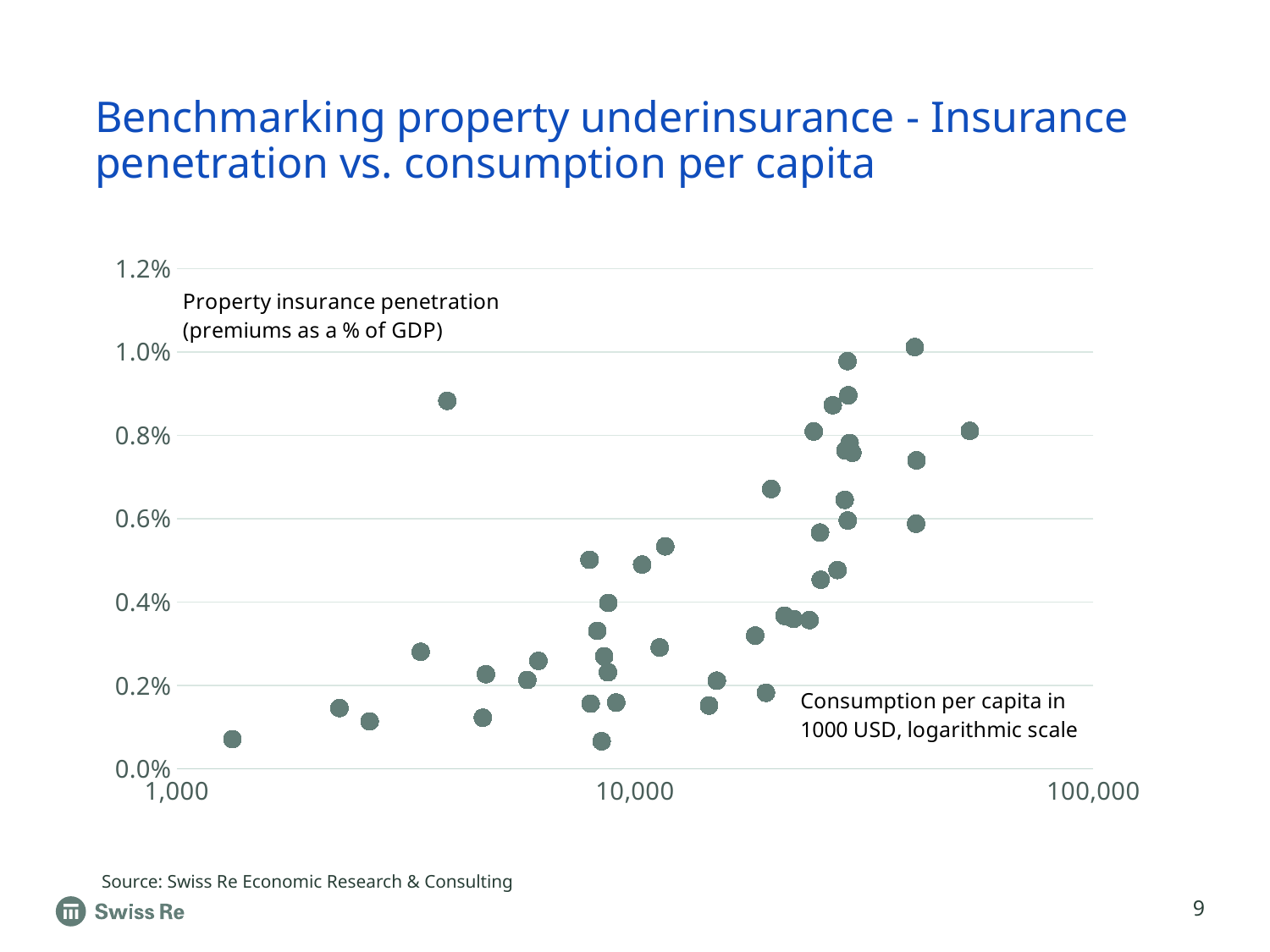
What does the horizontal axis of the chart measure? Consumption per capita in 1000 USD, logarithmic scale Is the value for the leftmost point on the chart greater or less than 0.2%? less Is the value for the highest point on the chart greater or less than 0.8%? greater What kind of chart is shown on the slide? Scatter plot As consumption per capita increases along the x axis, do the property insurance penetration values generally rise or fall? Rise Is the value for the rightmost point on the chart greater or less than 0.6%? greater What does the vertical axis of the chart measure? Property insurance penetration (premiums as a % of GDP)